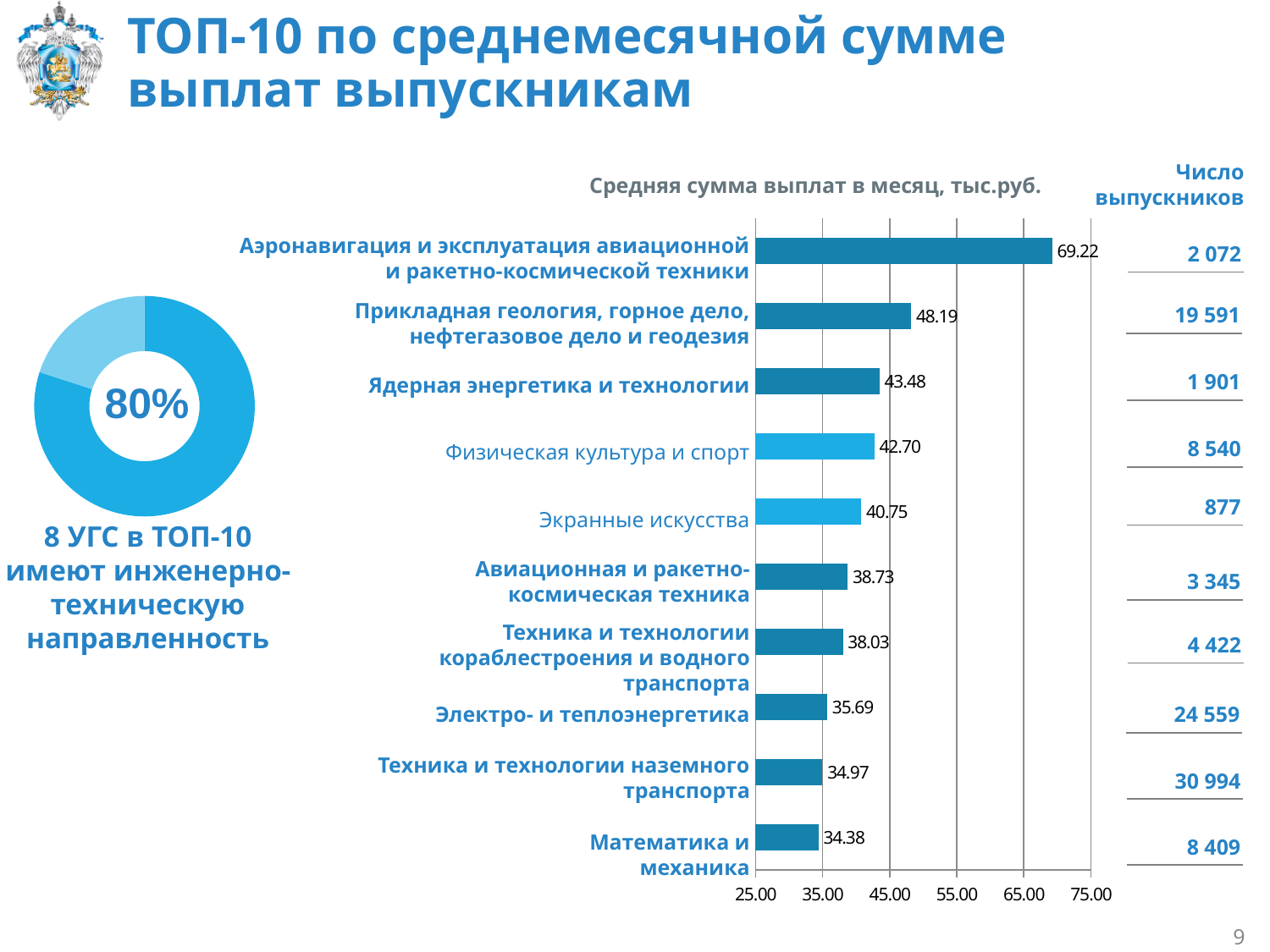
In the bar chart 'Средняя сумма выплат в месяц, тыс.руб.', which category has the highest value? Аэронавигация и эксплуатация авиационной и ракетно-космической техники In the bar chart 'Средняя сумма выплат в месяц, тыс.руб.', what is the value for Техника и технологии наземного транспорта? 34.97 In the bar chart 'Средняя сумма выплат в месяц, тыс.руб.', which category has the lowest value? Математика и механика What kind of chart is the chart on the left of the slide showing 80%? Donut chart In the bar chart 'Средняя сумма выплат в месяц, тыс.руб.', what is the value for Экранные искусства? 40.75 What percentage is shown in the centre of the donut chart on the left of the slide? 80% In the bar chart 'Средняя сумма выплат в месяц, тыс.руб.', which is larger: the value for Физическая культура и спорт or for Электро- и теплоэнергетика? Физическая культура и спорт How many categories are shown in the bar chart 'Средняя сумма выплат в месяц, тыс.руб.'? 10 What kind of chart is the chart titled 'Средняя сумма выплат в месяц, тыс.руб.'? Bar chart In the bar chart 'Средняя сумма выплат в месяц, тыс.руб.', is the value for Прикладная геология, горное дело, нефтегазовое дело и геодезия greater or less than 45.00? greater In the bar chart 'Средняя сумма выплат в месяц, тыс.руб.', what is the value for Ядерная энергетика и технологии? 43.48 In the bar chart 'Средняя сумма выплат в месяц, тыс.руб.', what is the difference between the values for Аэронавигация и эксплуатация авиационной и ракетно-космической техники and Прикладная геология, горное дело, нефтегазовое дело и геодезия? 21.03